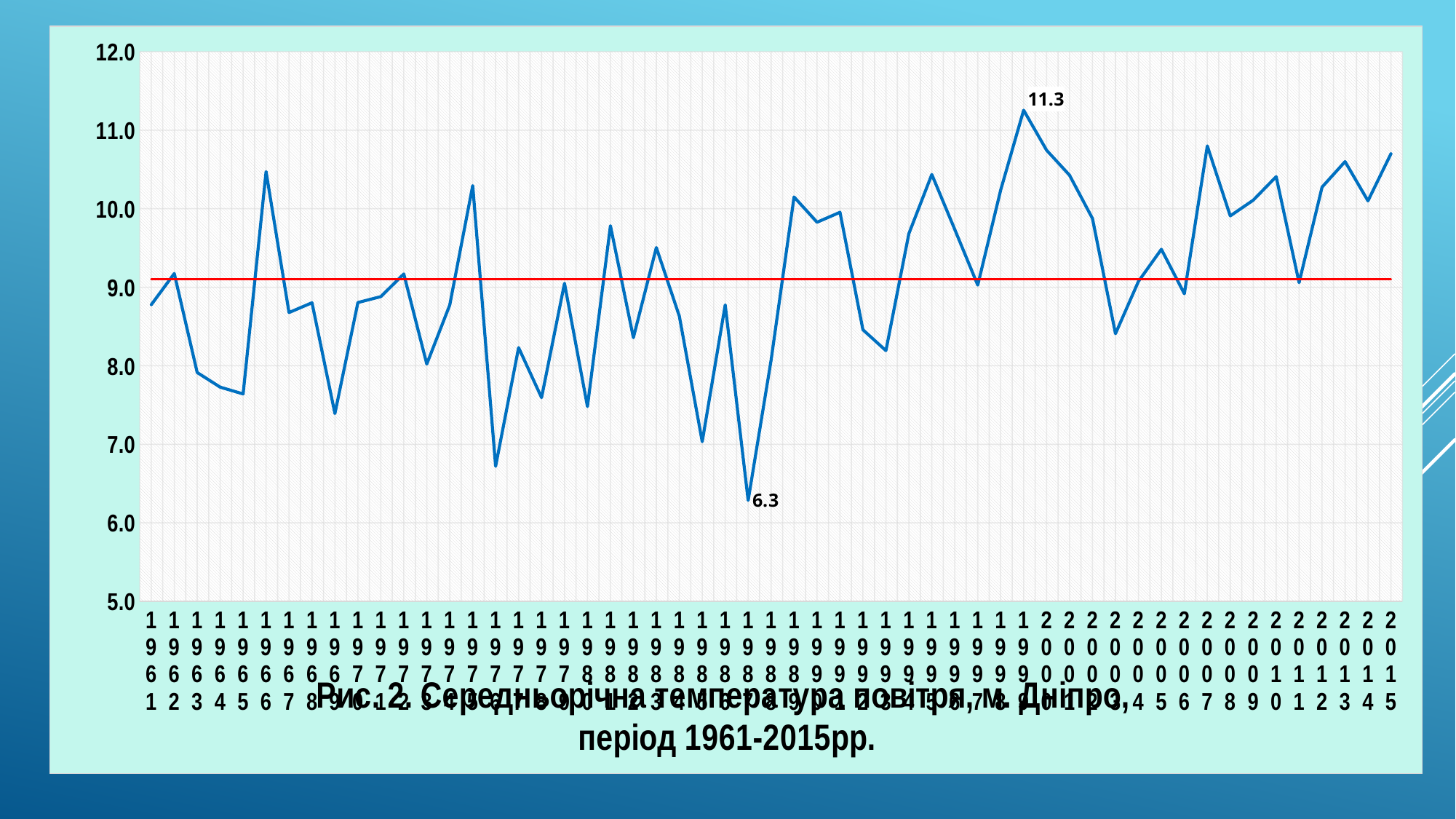
Is the value for 2007 greater or less than 10.0? greater What is the difference between the labelled values for 1999 and 1987? 5.0 What kind of chart is shown on the slide? line chart Which year has the larger value, 1999 or 1987? 1999 What is the highest value labelled on the chart, and in which year does it occur? 11.3 in 1999 How many years (data points) are plotted on the chart? 55 What is the lowest value labelled on the chart, and in which year does it occur? 6.3 in 1987 What is the value labelled for 1987? 6.3 Is the value for 1965 greater or less than 8.0? less What colour is the horizontal reference line drawn across the chart? red What is the value labelled for 1999? 11.3 Is the value for 1975 greater or less than 7.0? greater